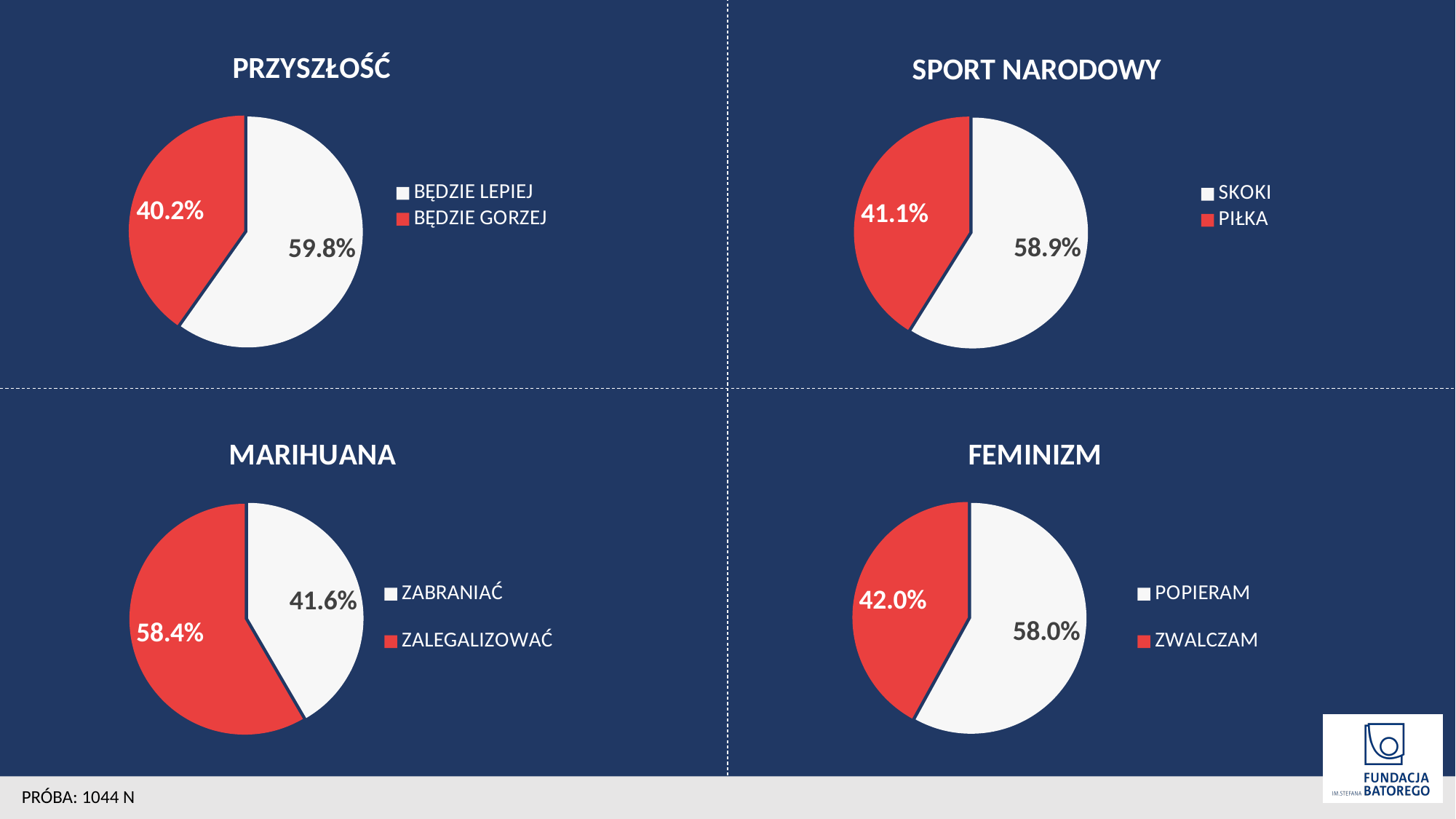
In the PRZYSZŁOŚĆ chart, what share is labelled for BĘDZIE GORZEJ? 40.2% In the MARIHUANA chart, which slice is the smallest? ZABRANIAĆ In the PRZYSZŁOŚĆ chart, which is larger, BĘDZIE LEPIEJ or BĘDZIE GORZEJ? BĘDZIE LEPIEJ In the PRZYSZŁOŚĆ chart, what share is labelled for BĘDZIE LEPIEJ? 59.8% In the MARIHUANA chart, what share is labelled for ZALEGALIZOWAĆ? 58.4% How many entries does the legend of the MARIHUANA chart list? 2 In the FEMINIZM chart, what share is labelled for POPIERAM? 58.0% In the SPORT NARODOWY chart, which slice is the largest? SKOKI What kind of chart is used in the SPORT NARODOWY section? Pie chart In the SPORT NARODOWY chart, what share is labelled for PIŁKA? 41.1% In the FEMINIZM chart, what colour is the ZWALCZAM slice? Red In the FEMINIZM chart, what is the difference in percentage points between POPIERAM and ZWALCZAM? 16.0